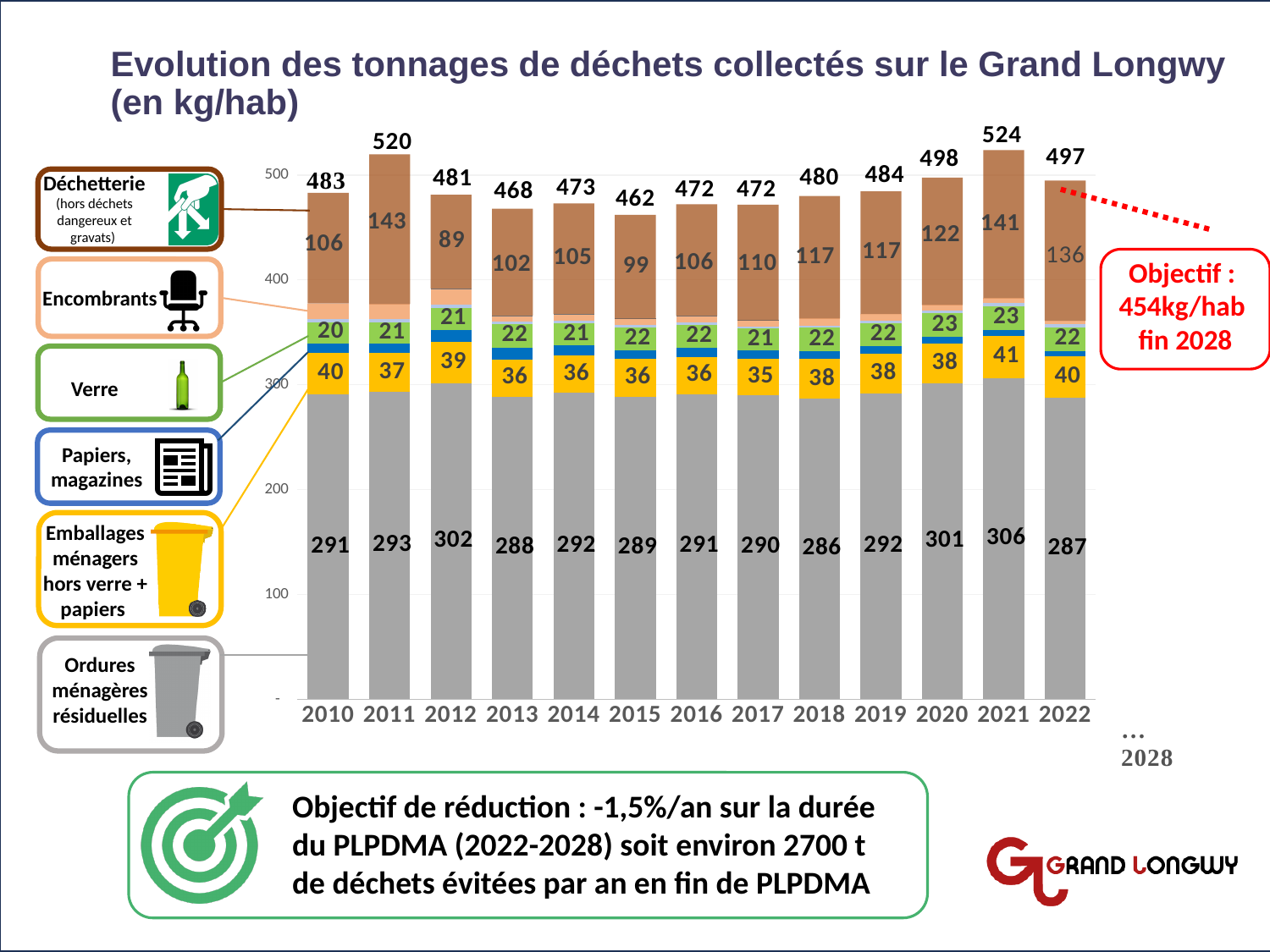
What is the total tonnage (kg/hab) shown above the bar for 2021? 524 Which year has the highest total tonnage per inhabitant? 2021 What is the value of the Verre segment for 2020? 23 What kind of chart is used to show the evolution of waste tonnages? Stacked bar chart How many waste categories are listed in the legend on the left of the chart? 6 What is the value of the Déchetterie segment for 2011? 143 What is the value of the Ordures ménagères résiduelles segment for 2012? 302 What is the difference between the Déchetterie value for 2022 and for 2012? 47 Which year has the lowest total tonnage per inhabitant? 2015 What is the difference between the total for 2021 and the total for 2015? 62 How many years are shown on the x axis of the chart? 13 Which is larger, the Ordures ménagères résiduelles value for 2020 or for 2022? 2020